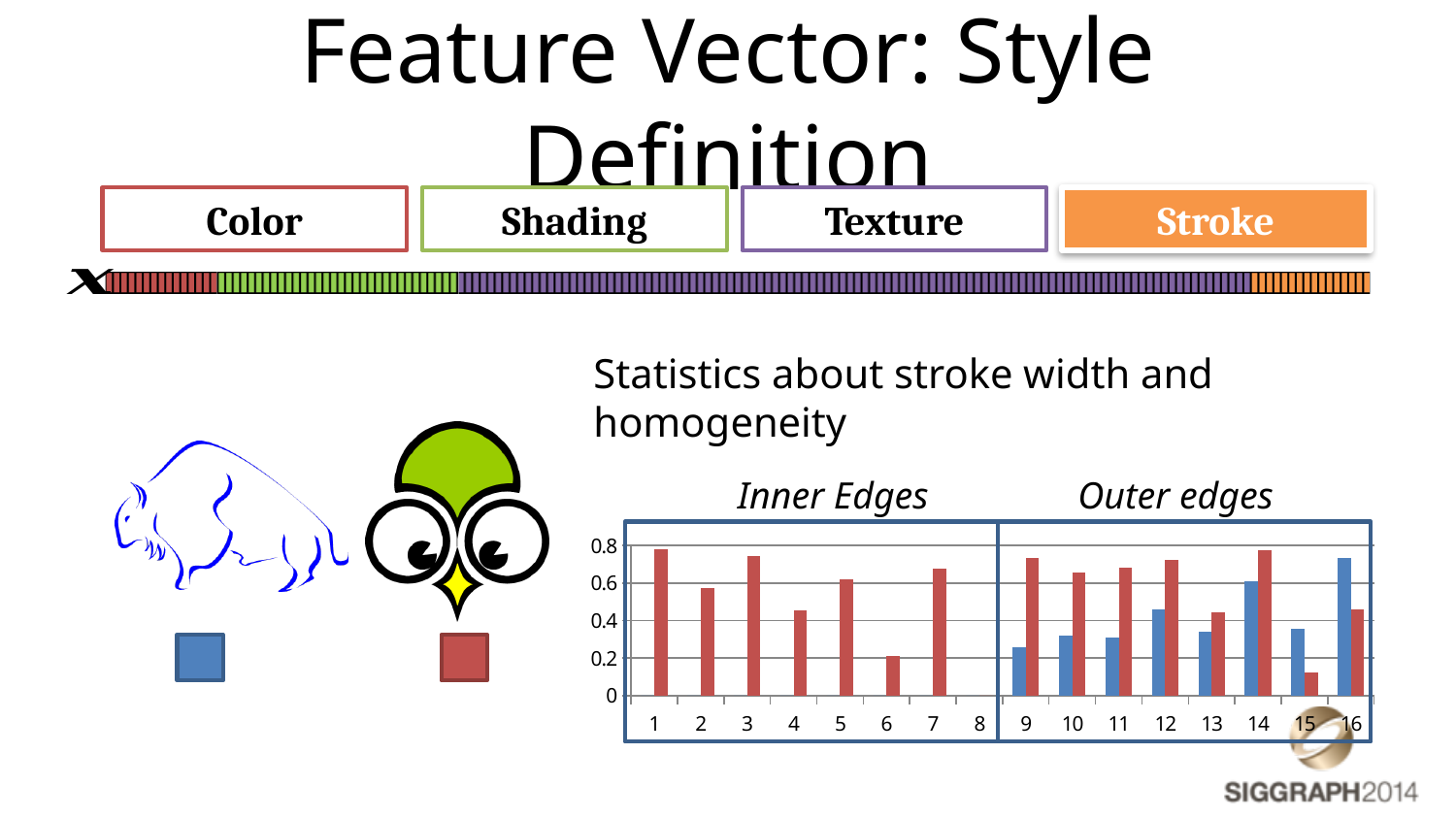
At category 9, which bar is taller, the blue one or the red one? red Among the red bars in the Inner Edges section (categories 1 to 7), which category has the lowest value? 6 Is the blue bar for category 16 greater or less than 0.6? greater Is the red bar for category 15 greater or less than 0.2? less How many numbered categories are shown along the x axis of the chart? 16 Is the red bar for category 1 greater or less than 0.6? greater At category 16, which bar is taller, the blue one or the red one? blue What are the two labelled sections of the chart? Inner Edges and Outer edges What kind of chart is shown on the slide? bar chart Among the blue bars in the Outer edges section, which category has the highest value? 16